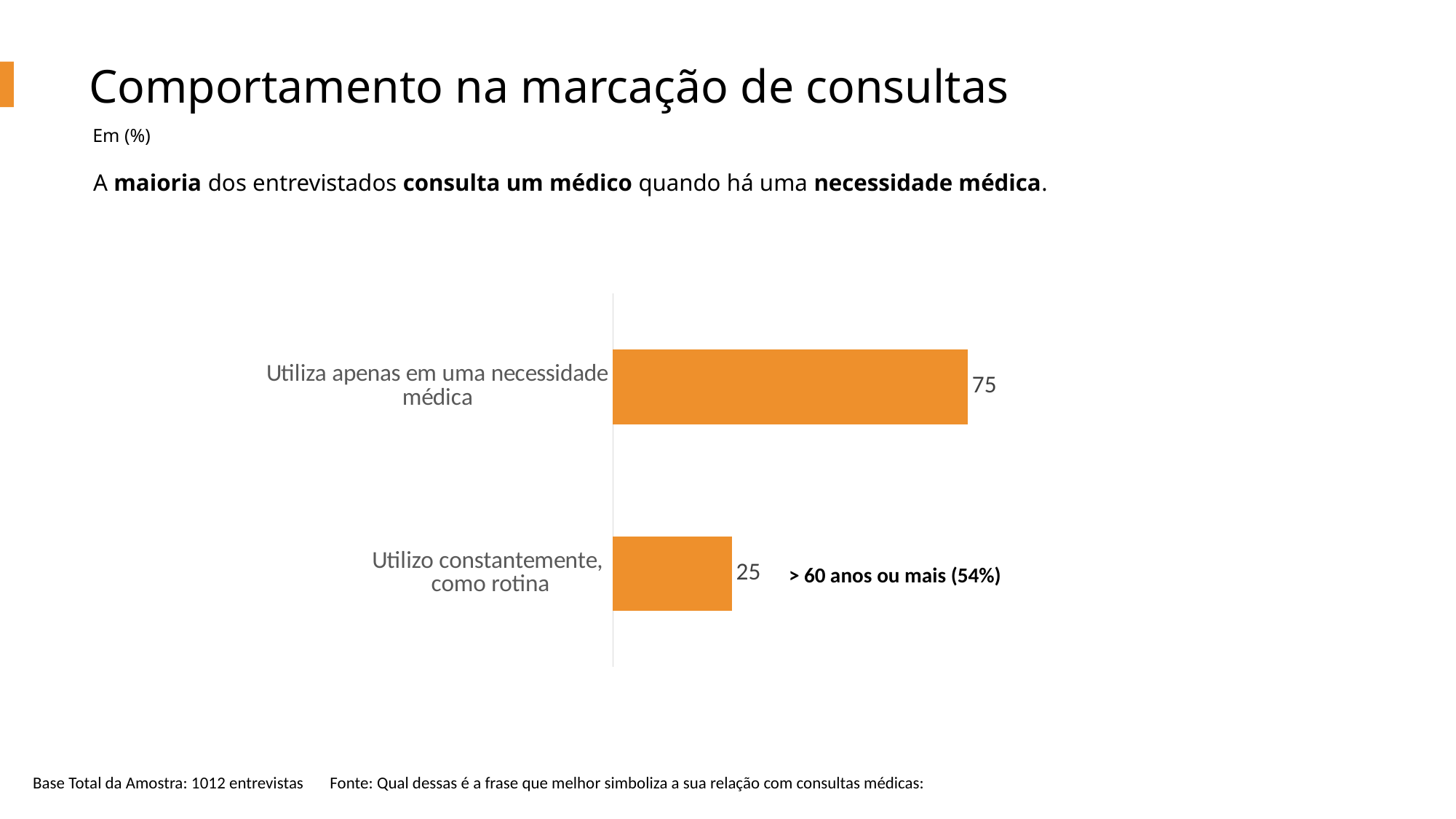
What colour are the bars in the chart? Orange Which is larger: the value for "Utiliza apenas em uma necessidade médica" or for "Utilizo constantemente, como rotina"? Utiliza apenas em uma necessidade médica Which category has the lowest value? Utilizo constantemente, como rotina What is the title of the slide containing the chart? Comportamento na marcação de consultas What is the total of the two values shown in the chart? 100 What percentage is noted next to the "Utilizo constantemente, como rotina" bar for the group "> 60 anos ou mais"? 54% What is the value for "Utiliza apenas em uma necessidade médica"? 75 How many categories does the chart show? 2 What is the difference between the values for "Utiliza apenas em uma necessidade médica" and "Utilizo constantemente, como rotina"? 50 What kind of chart is shown on the slide? Bar chart What is the value for "Utilizo constantemente, como rotina"? 25 Which category has the highest value? Utiliza apenas em uma necessidade médica